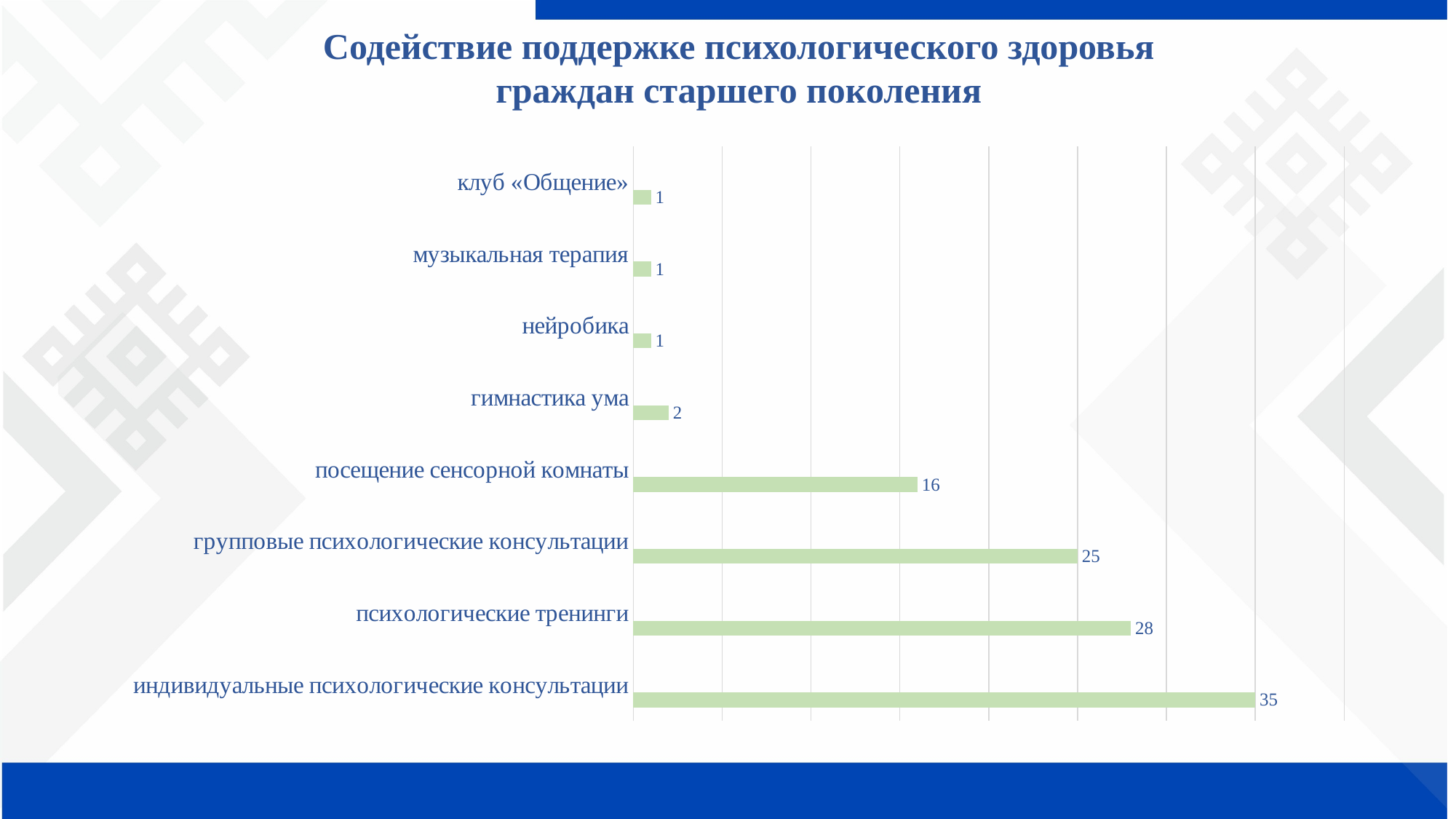
What kind of chart is shown on the slide? bar chart How many categories have a value of 1? 3 What is the value for «гимнастика ума»? 2 What is the value for «индивидуальные психологические консультации»? 35 How many categories are shown in the chart? 8 What is the difference between the values for «индивидуальные психологические консультации» and «посещение сенсорной комнаты»? 19 What is the difference between the values for «психологические тренинги» and «групповые психологические консультации»? 3 What is the title of the chart? Содействие поддержке психологического здоровья граждан старшего поколения What is the value for «психологические тренинги»? 28 What is the value for «посещение сенсорной комнаты»? 16 Which category has the highest value? индивидуальные психологические консультации Which is larger: the value for «групповые психологические консультации» or «посещение сенсорной комнаты»? групповые психологические консультации